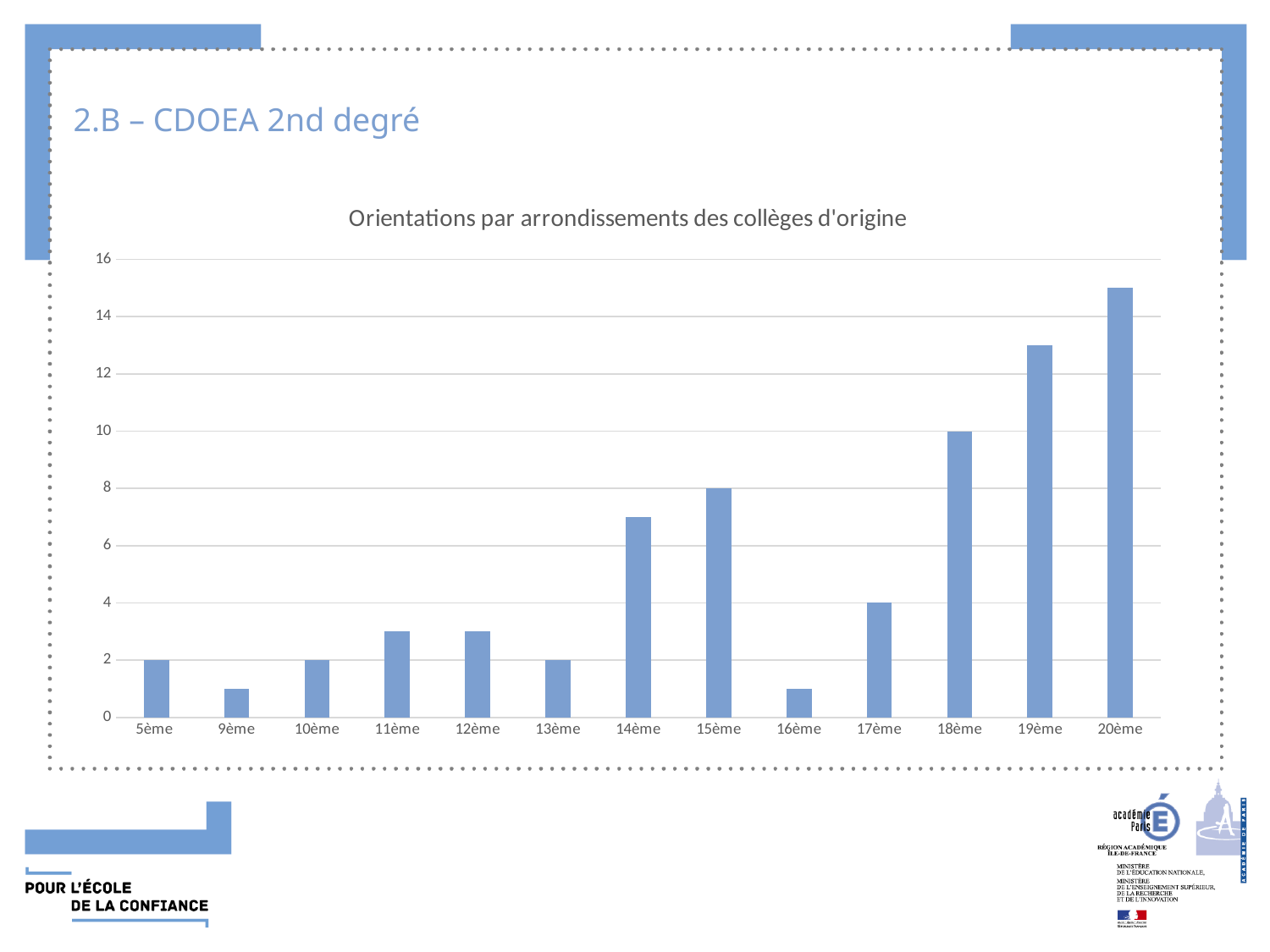
Is the value for 20ème greater or less than 14? greater What is the difference between the values for 18ème and 15ème? 2 What is the title of the chart? Orientations par arrondissements des collèges d'origine What is the value for 18ème? 10 What is the value for 15ème? 8 Which arrondissement has the highest value? 20ème Is the value for 9ème greater or less than 2? less What is the value for 5ème? 2 What type of chart is shown on the slide? bar chart What is the value for 17ème? 4 How many arrondissements are shown on the x axis? 13 Which is larger, the value for 19ème or the value for 14ème? 19ème